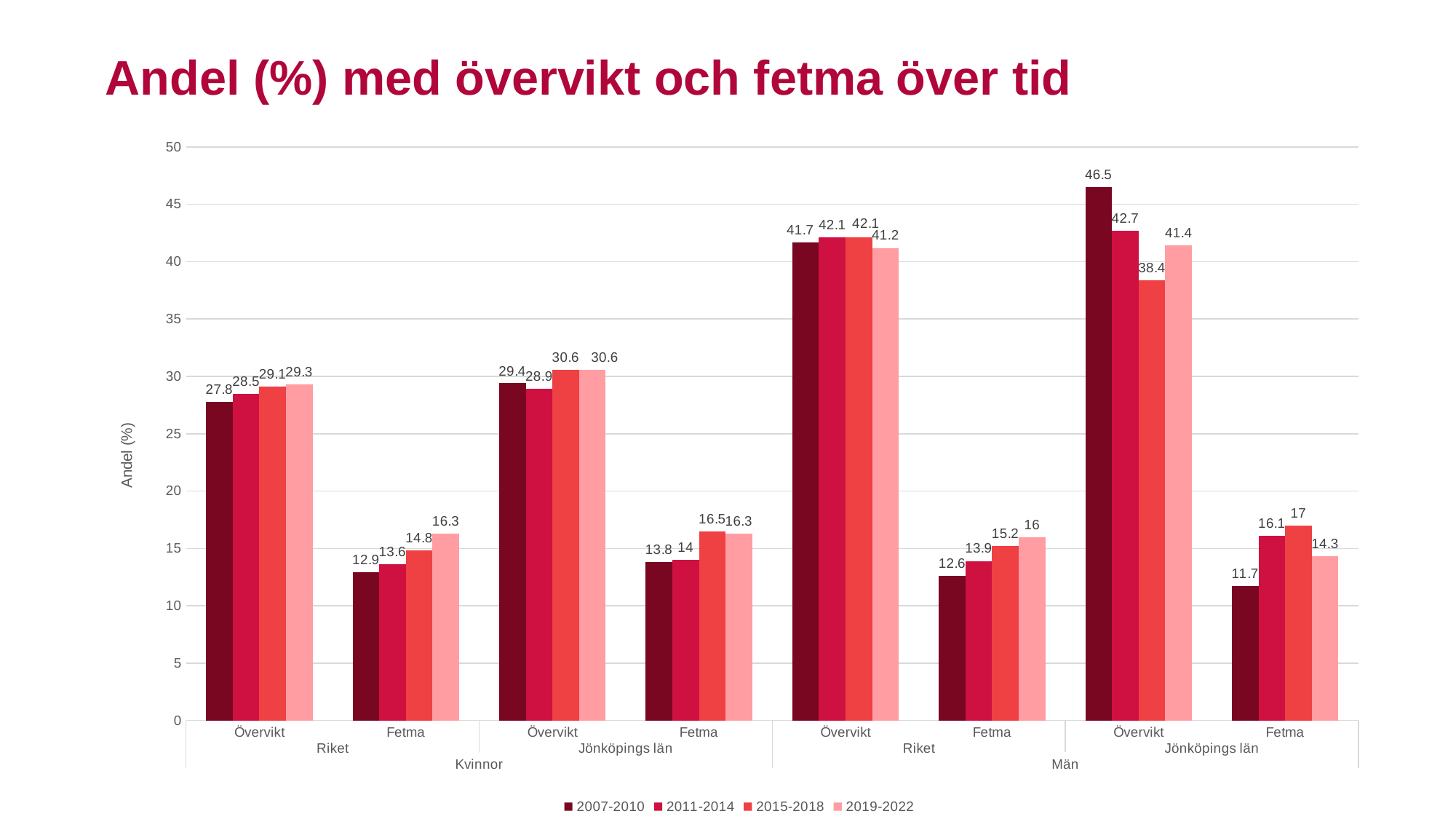
What kind of chart is shown on the slide? Bar chart How many series does the legend list? 4 Is the 2019-2022 value for Övervikt among Män in Riket greater or less than 40? greater Do the values for Fetma among Kvinnor in Riket rise or fall from 2007-2010 to 2019-2022? Rise What is the value for Övervikt among Män in Jönköpings län for 2007-2010? 46.5 What is the value for Övervikt among Kvinnor in Jönköpings län for 2015-2018? 30.6 Which bar in the whole chart has the lowest value? Fetma, Män, Jönköpings län, 2007-2010 (11.7) Which bar in the whole chart has the highest value? Övervikt, Män, Jönköpings län, 2007-2010 (46.5) What is the value for Fetma among Män in Jönköpings län for 2011-2014? 16.1 Which is larger: the 2019-2022 value for Fetma among Kvinnor in Riket or the 2019-2022 value for Fetma among Män in Riket? Kvinnor in Riket (16.3) What is the difference between the 2007-2010 and 2015-2018 values for Övervikt among Män in Jönköpings län? 8.1 What is the value for Fetma among Kvinnor in Riket for 2019-2022? 16.3